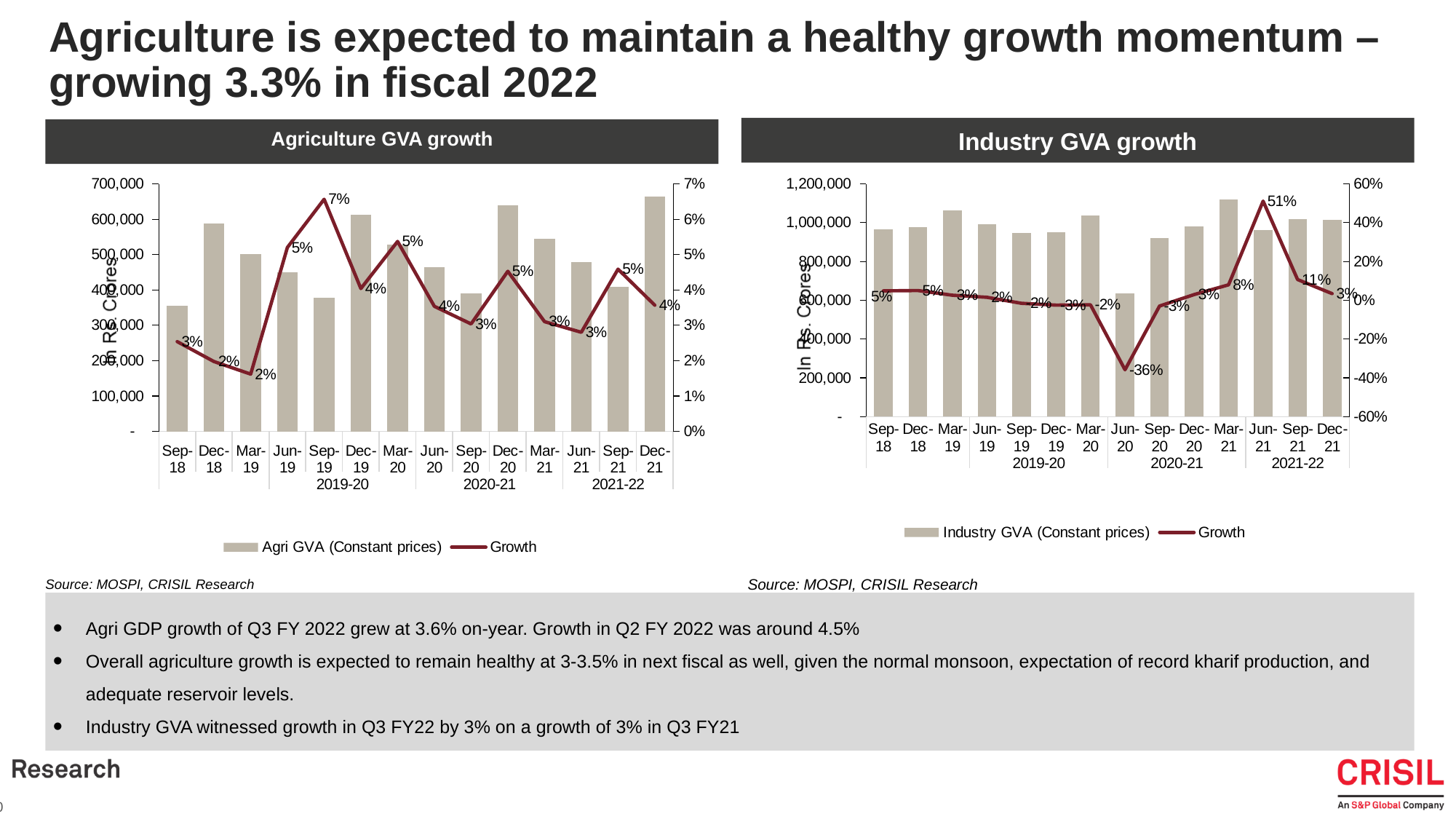
On the Agriculture GVA growth chart, which period has the highest growth value? Sep-19 How many periods are shown on the x axis of the Agriculture GVA growth chart? 14 On the Industry GVA growth chart, what is the growth value shown for Jun-20? -36% On the Industry GVA growth chart, what is the growth value shown for Jun-21? 51% How many series does the legend of the Industry GVA growth chart list? 2 On the Agriculture GVA growth chart, which has the larger growth value, Sep-19 or Mar-20? Sep-19 On the Industry GVA growth chart, which period has the lowest growth value? Jun-20 On the Industry GVA growth chart, which period has the highest growth value? Jun-21 On the Agriculture GVA growth chart, is the Agri GVA bar for Dec-21 greater or less than 600,000? greater On the Industry GVA growth chart, is the Industry GVA bar for Jun-20 greater or less than 800,000? less On the Agriculture GVA growth chart, what is the growth value shown for Sep-19? 7% What kind of chart is the Agriculture GVA growth chart? Combined bar and line chart